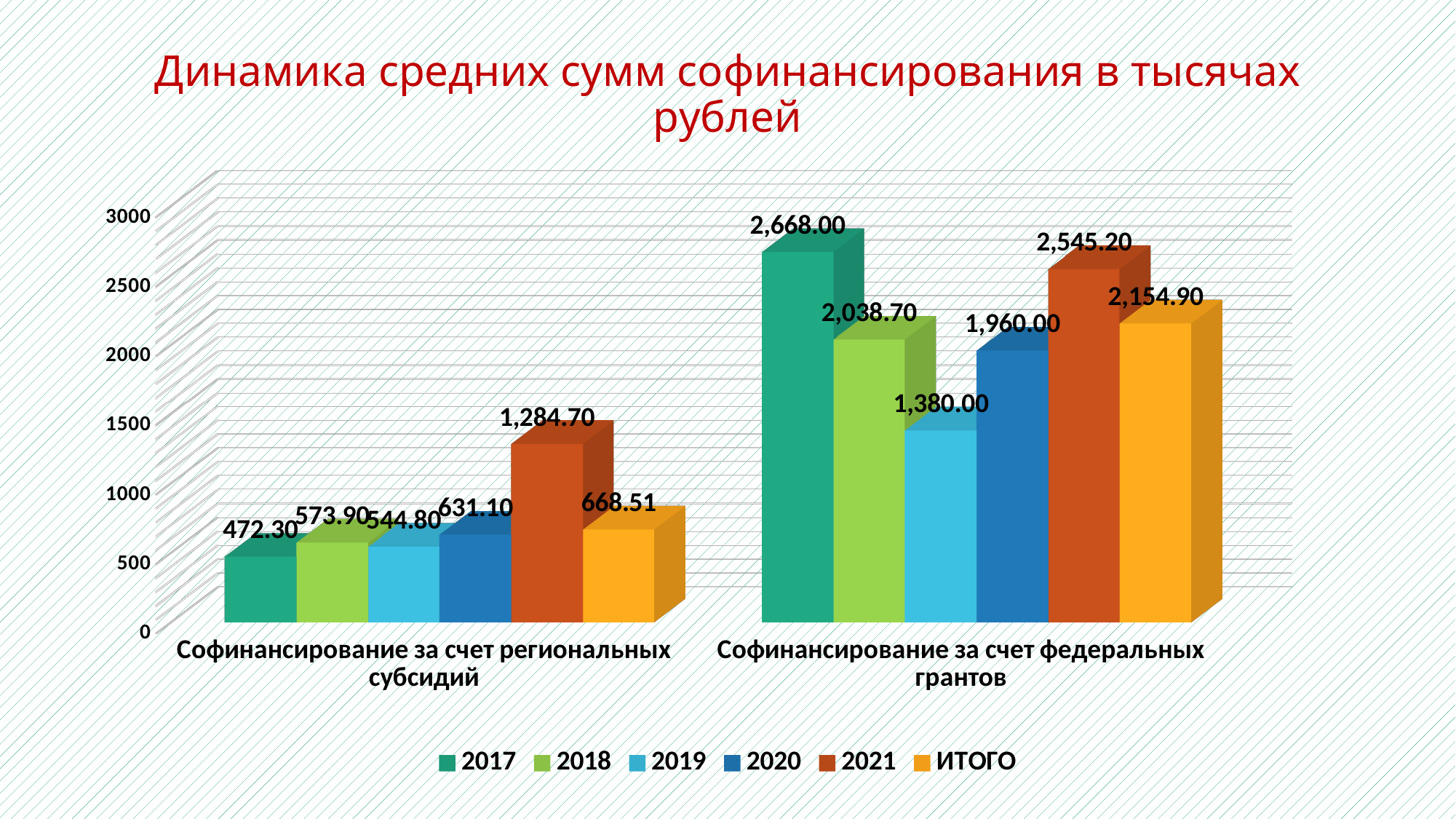
What is the value for 2019 in the category "Софинансирование за счет федеральных грантов"? 1,380.00 What is the value for 2021 in the category "Софинансирование за счет региональных субсидий"? 1,284.70 What is the difference between the 2017 and 2019 values for "Софинансирование за счет федеральных грантов"? 1,288.00 What kind of chart is shown on the slide? bar chart Is the 2020 value for "Софинансирование за счет региональных субсидий" greater or less than 1000? less Which year has the highest value in the category "Софинансирование за счет федеральных грантов"? 2017 How many series does the legend list? 6 What is the title of the chart? Динамика средних сумм софинансирования в тысячах рублей Which is larger: the 2018 value or the 2020 value for "Софинансирование за счет федеральных грантов"? 2018 What is the difference between the 2021 and 2017 values for "Софинансирование за счет региональных субсидий"? 812.40 Which year has the lowest value in the category "Софинансирование за счет региональных субсидий"? 2017 What is the ИТОГО value for "Софинансирование за счет федеральных грантов"? 2,154.90